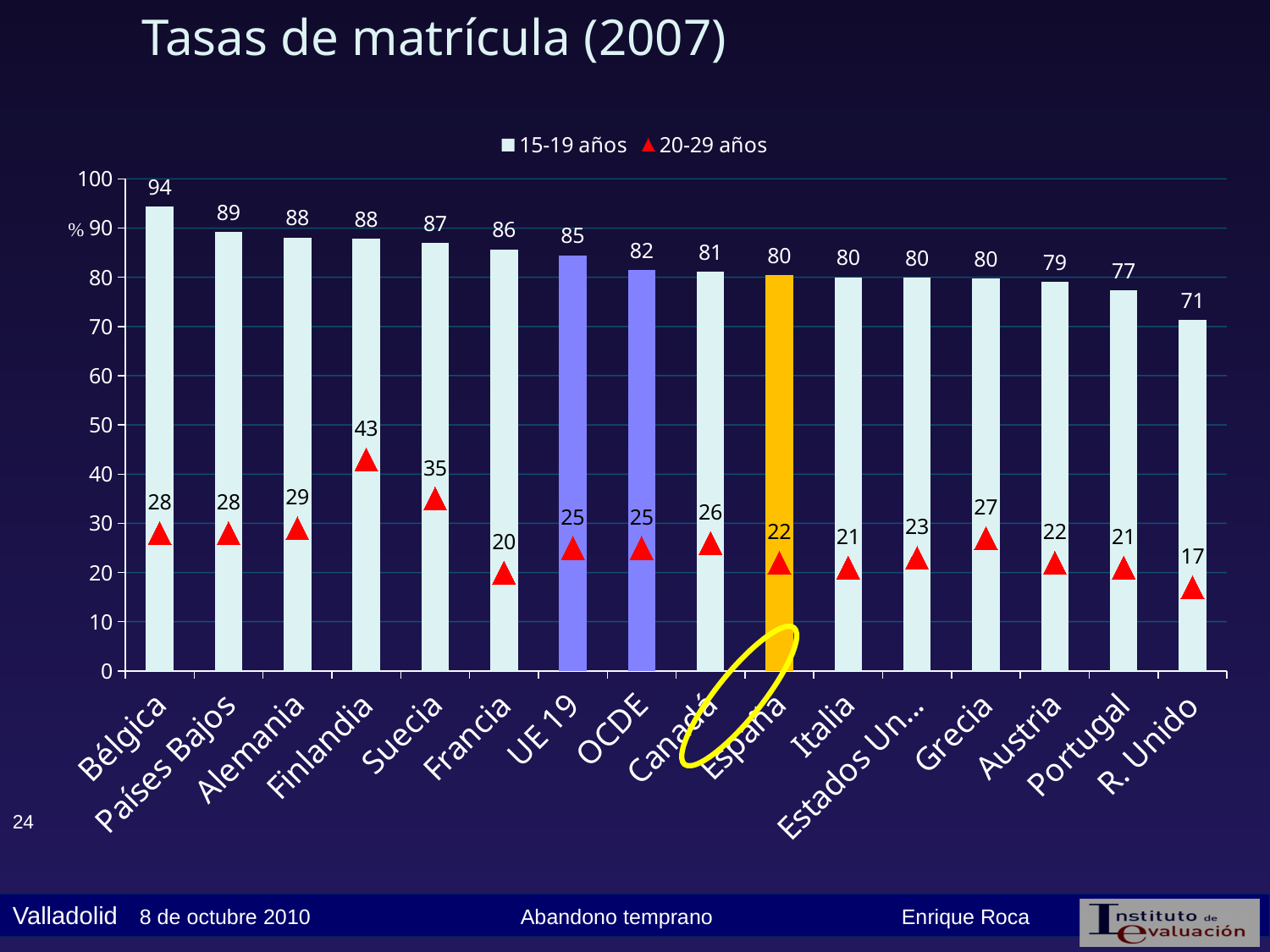
What is the value for Finlandia in the 20-29 años series? 43 Do the 15-19 años values generally rise or fall from left to right along the x axis? fall What is the value for Bélgica in the 15-19 años series? 94 How many series does the legend list? 2 What is the difference between the 15-19 años values for Bélgica and España? 14 What is the value for R. Unido in the 20-29 años series? 17 Which category has the lowest value in the 15-19 años series? R. Unido What is the value for España in the 15-19 años series? 80 Which has a larger 15-19 años value, Países Bajos or Portugal? Países Bajos Which country has the highest value in the 15-19 años series? Bélgica Which category has the highest value in the 20-29 años series? Finlandia How many categories are shown on the x axis? 16